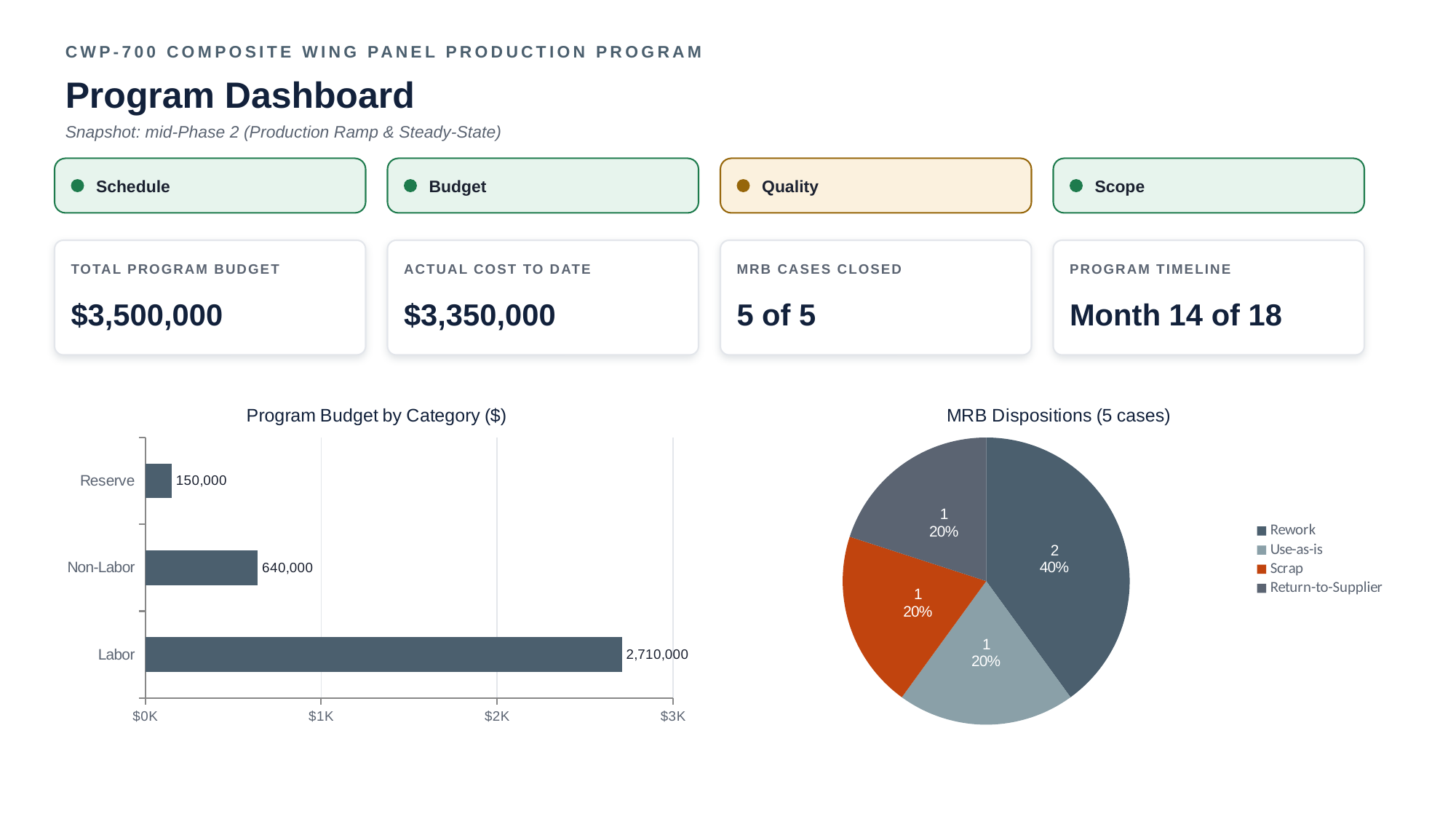
In the Program Budget by Category chart, what is the value for Non-Labor? 640,000 In the Program Budget by Category chart, which category has the lowest value? Reserve In the Program Budget by Category chart, what is the value for Labor? 2,710,000 In the MRB Dispositions chart, what share of cases is Rework? 40% In the MRB Dispositions chart, how many cases are Scrap? 1 In the Program Budget by Category chart, which category has the highest value? Labor In the MRB Dispositions chart, which disposition has the largest slice? Rework In the Program Budget by Category chart, how many categories are shown? 3 How many entries does the legend of the MRB Dispositions chart list? 4 In the Program Budget by Category chart, what is the difference between the Non-Labor and Reserve values? 490,000 What kind of chart is the Program Budget by Category chart? Bar chart In the Program Budget by Category chart, what is the value for Reserve? 150,000